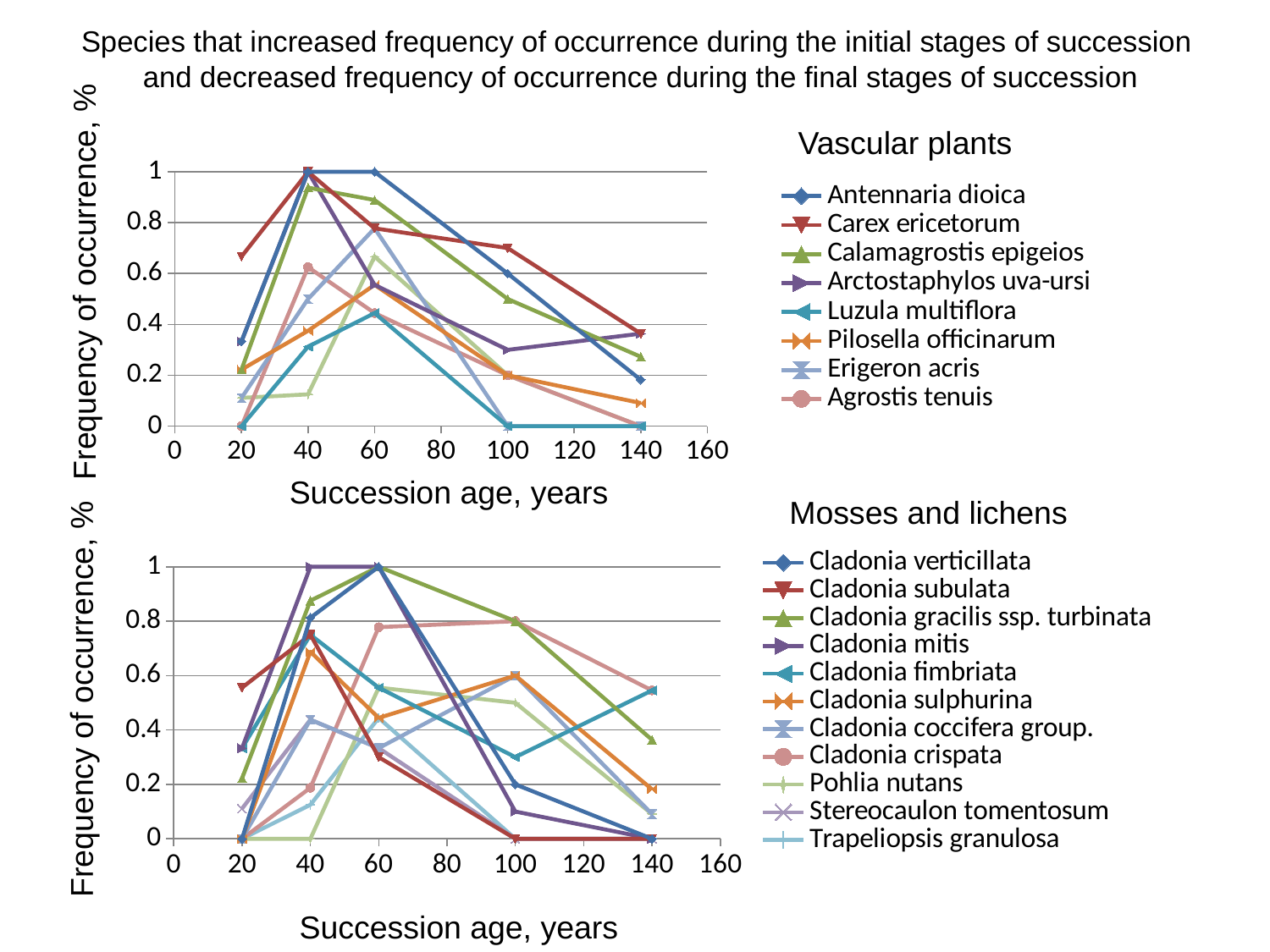
What kind of chart is the Vascular plants chart? line chart How many series does the legend of the Mosses and lichens chart list? 11 In the Vascular plants chart, what is the frequency of occurrence for Luzula multiflora at succession age 140 years? 0 In the Vascular plants chart, is the value for Carex ericetorum at succession age 100 years greater or less than 0.6? greater In the Mosses and lichens chart, is the value for Cladonia crispata at succession age 100 years greater or less than 0.6? greater In the Mosses and lichens chart, what is the frequency of occurrence for Cladonia mitis at succession age 40 years? 1 How many series does the legend of the Vascular plants chart list? 8 In the Mosses and lichens chart, which is larger at succession age 100 years: Cladonia gracilis ssp. turbinata or Cladonia mitis? Cladonia gracilis ssp. turbinata In the Mosses and lichens chart, does the value for Cladonia subulata rise or fall from succession age 40 years to 140 years? fall What is the x-axis title of the Vascular plants chart? Succession age, years In the Mosses and lichens chart, what is the frequency of occurrence for Cladonia subulata at succession age 140 years? 0 In the Vascular plants chart, what is the frequency of occurrence for Antennaria dioica at succession age 60 years? 1